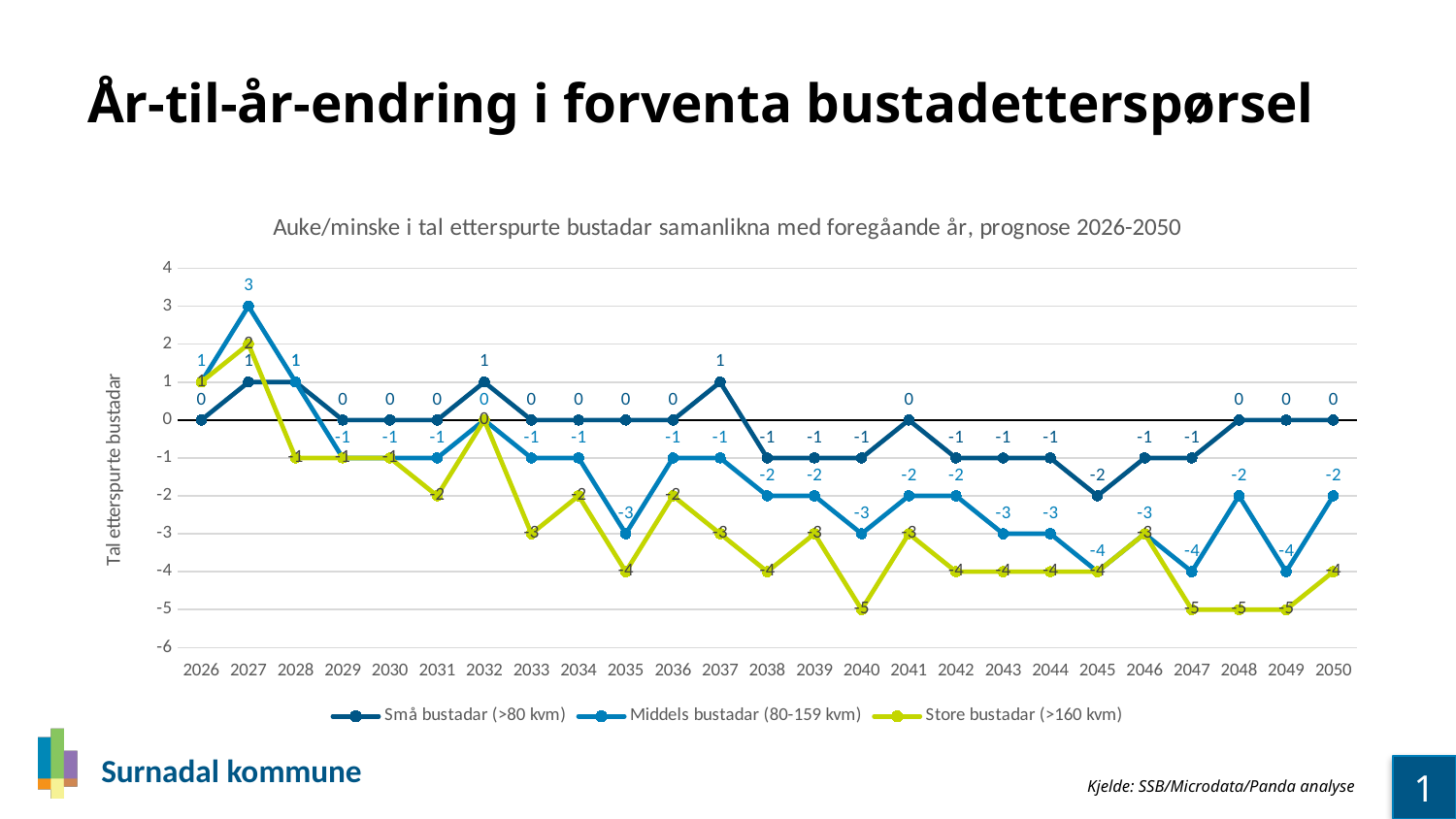
What kind of chart is shown on the slide? Line chart In which year does Middels bustadar (80-159 kvm) reach its highest value? 2027 How many series does the legend list? 3 Do the values for Store bustadar (>160 kvm) generally rise or fall from 2026 to 2050? Fall How many years are plotted along the x axis? 25 What is the lowest value reached by Store bustadar (>160 kvm)? -5 What is the value for Små bustadar (>80 kvm) in 2045? -2 What is the value for Middels bustadar (80-159 kvm) in 2027? 3 What is the difference between Middels bustadar (80-159 kvm) and Store bustadar (>160 kvm) in 2027? 1 In 2035, which is larger: Middels bustadar (80-159 kvm) or Store bustadar (>160 kvm)? Middels bustadar (80-159 kvm) What is the subtitle shown above the chart? Auke/minske i tal etterspurte bustadar samanlikna med foregåande år, prognose 2026-2050 What is the value for Store bustadar (>160 kvm) in 2040? -5